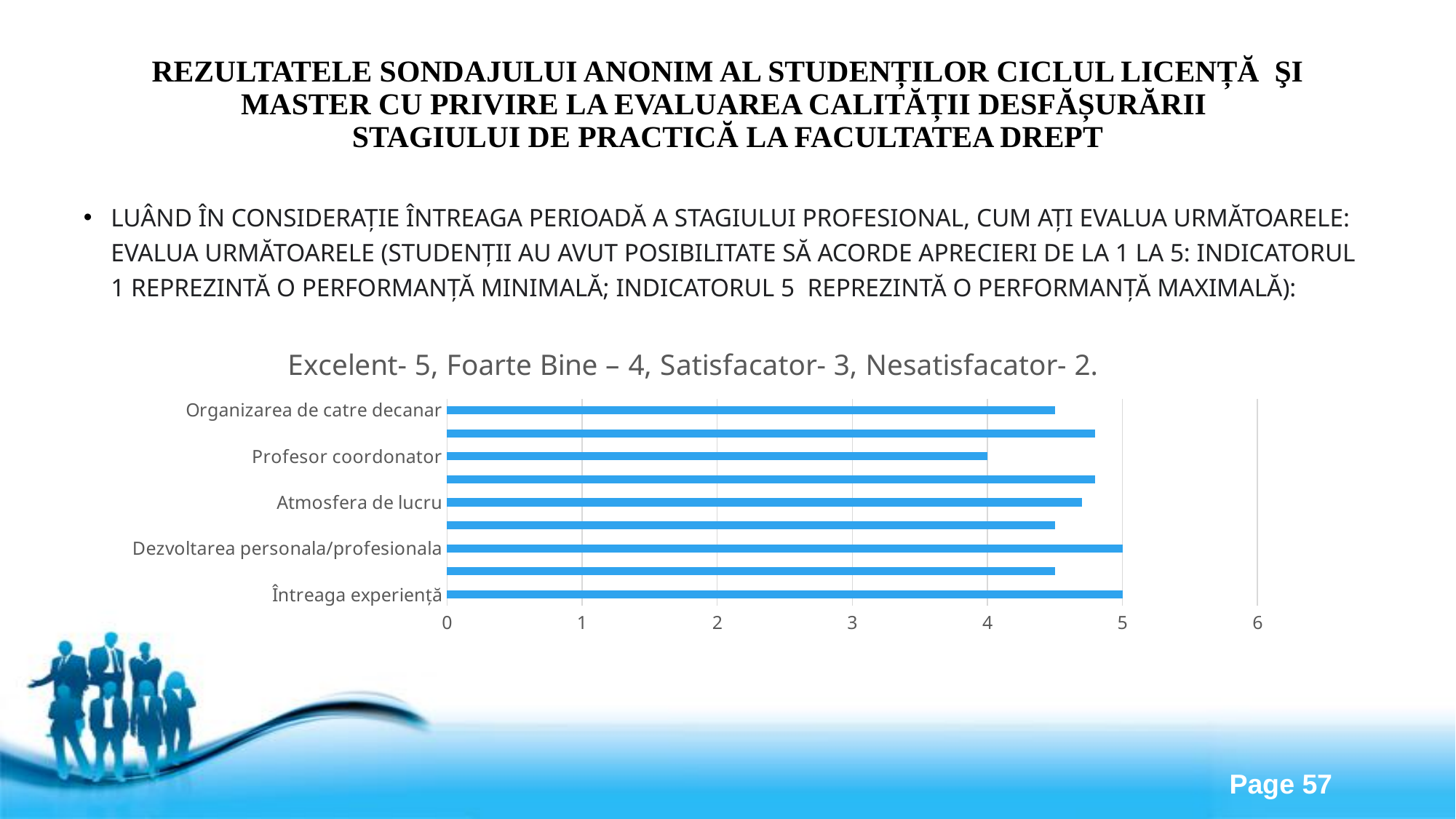
Which is larger, the value for Profesor coordonator or the value for Atmosfera de lucru? Atmosfera de lucru What is the value for Profesor coordonator? 4 What is the difference between the value for Dezvoltarea personala/profesionala and the value for Profesor coordonator? 1 Which is larger, the value for Dezvoltarea personala/profesionala or the value for Organizarea de catre decanar? Dezvoltarea personala/profesionala What is the title of the chart? Excelent- 5, Foarte Bine – 4, Satisfacator- 3, Nesatisfacator- 2. What is the value for Întreaga experiență? 5 How many bars are plotted in the chart? 9 What is the value for Dezvoltarea personala/profesionala? 5 Which labelled category has the lowest value? Profesor coordonator Is the value for Organizarea de catre decanar greater or less than 4? greater Is the value for Atmosfera de lucru greater or less than 5? less What kind of chart is shown on the slide? bar chart